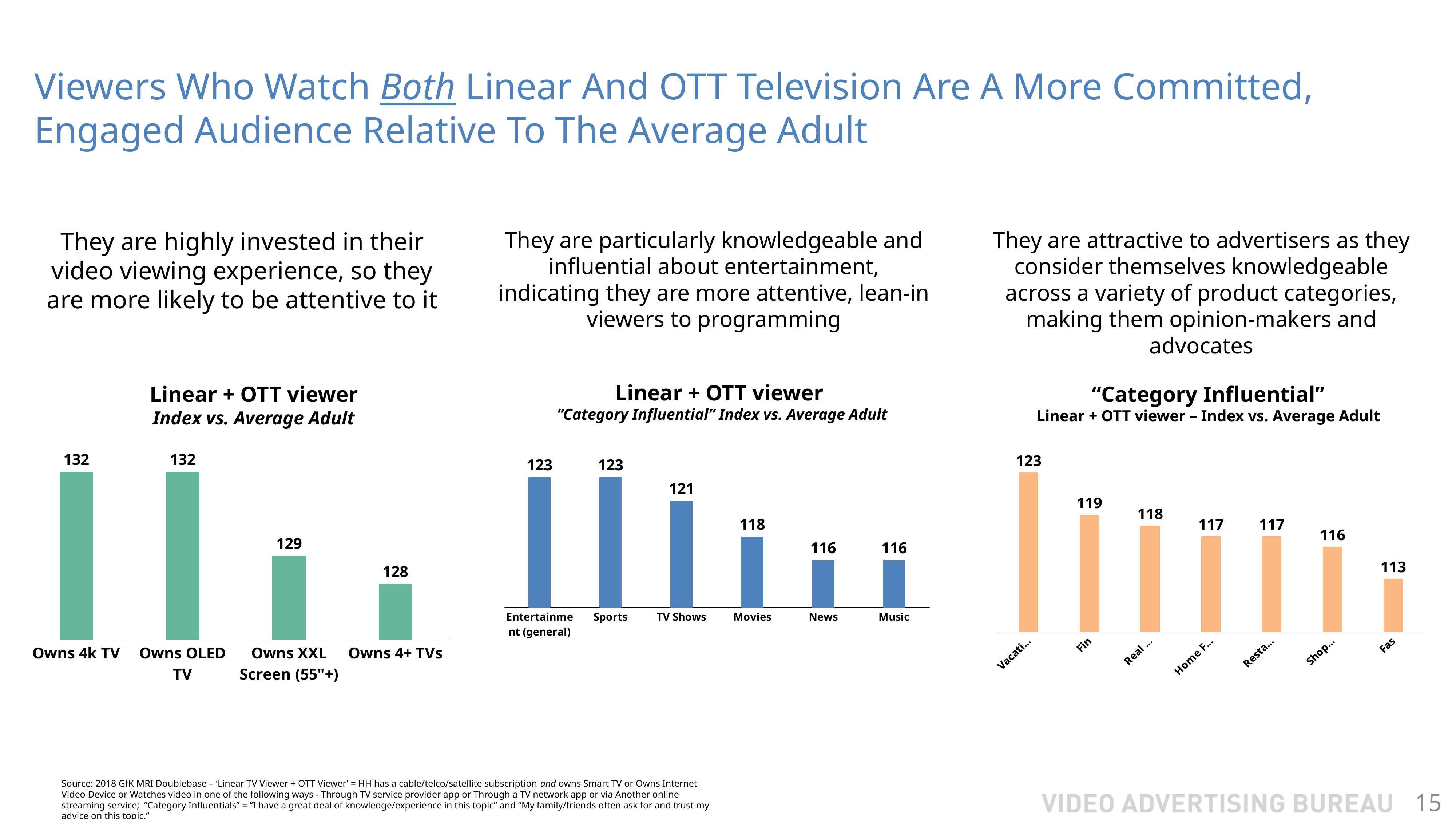
What type of chart is the right chart titled "Category Influential"? Bar chart In the middle chart ("Category Influential" Index vs. Average Adult), what is the index value for Movies? 118 In the left chart (Linear + OTT viewer Index vs. Average Adult), what is the index value for Owns 4k TV? 132 In the left chart (Linear + OTT viewer Index vs. Average Adult), which category has the lowest index? Owns 4+ TVs In the left chart (Linear + OTT viewer Index vs. Average Adult), what is the difference between the index for Owns OLED TV and Owns XXL Screen (55"+)? 3 In the right chart titled "Category Influential", what is the highest index value shown? 123 How many categories are shown in the left chart (Linear + OTT viewer Index vs. Average Adult)? 4 In the middle chart ("Category Influential" Index vs. Average Adult), which is larger, the index for Sports or the index for News? Sports In the middle chart ("Category Influential" Index vs. Average Adult), what is the index value for TV Shows? 121 How many categories are shown in the middle chart ("Category Influential" Index vs. Average Adult)? 6 In the left chart (Linear + OTT viewer Index vs. Average Adult), what is the index value for Owns 4+ TVs? 128 In the middle chart ("Category Influential" Index vs. Average Adult), what is the difference between the index for Entertainment (general) and Music? 7